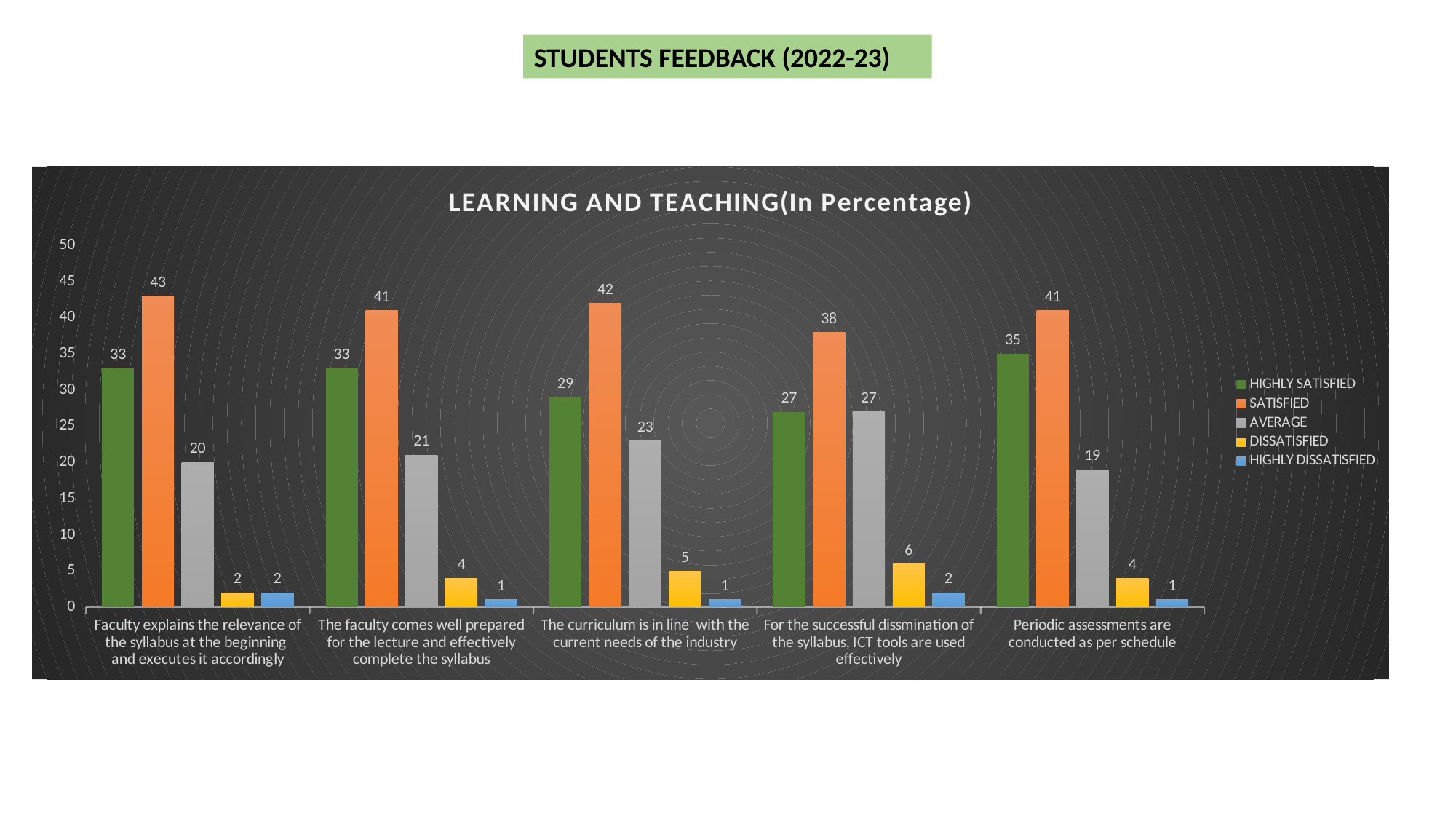
What kind of chart is shown? Bar chart What is the HIGHLY SATISFIED value for 'Periodic assessments are conducted as per schedule'? 35 Which category has the lowest HIGHLY SATISFIED value? For the successful dissmination of the syllabus, ICT tools are used effectively How many categories are shown on the x axis? 5 Which is larger for 'The faculty comes well prepared for the lecture and effectively complete the syllabus': the DISSATISFIED value or the HIGHLY DISSATISFIED value? DISSATISFIED What is the SATISFIED value for 'Faculty explains the relevance of the syllabus at the beginning and executes it accordingly'? 43 How many series does the legend list? 5 Which colour represents the AVERAGE series in the legend? Grey What is the AVERAGE value for 'The curriculum is in line with the current needs of the industry'? 23 What is the difference between the SATISFIED and HIGHLY SATISFIED values for 'For the successful dissmination of the syllabus, ICT tools are used effectively'? 11 Which category has the highest SATISFIED value? Faculty explains the relevance of the syllabus at the beginning and executes it accordingly What is the title of the chart? LEARNING AND TEACHING(In Percentage)